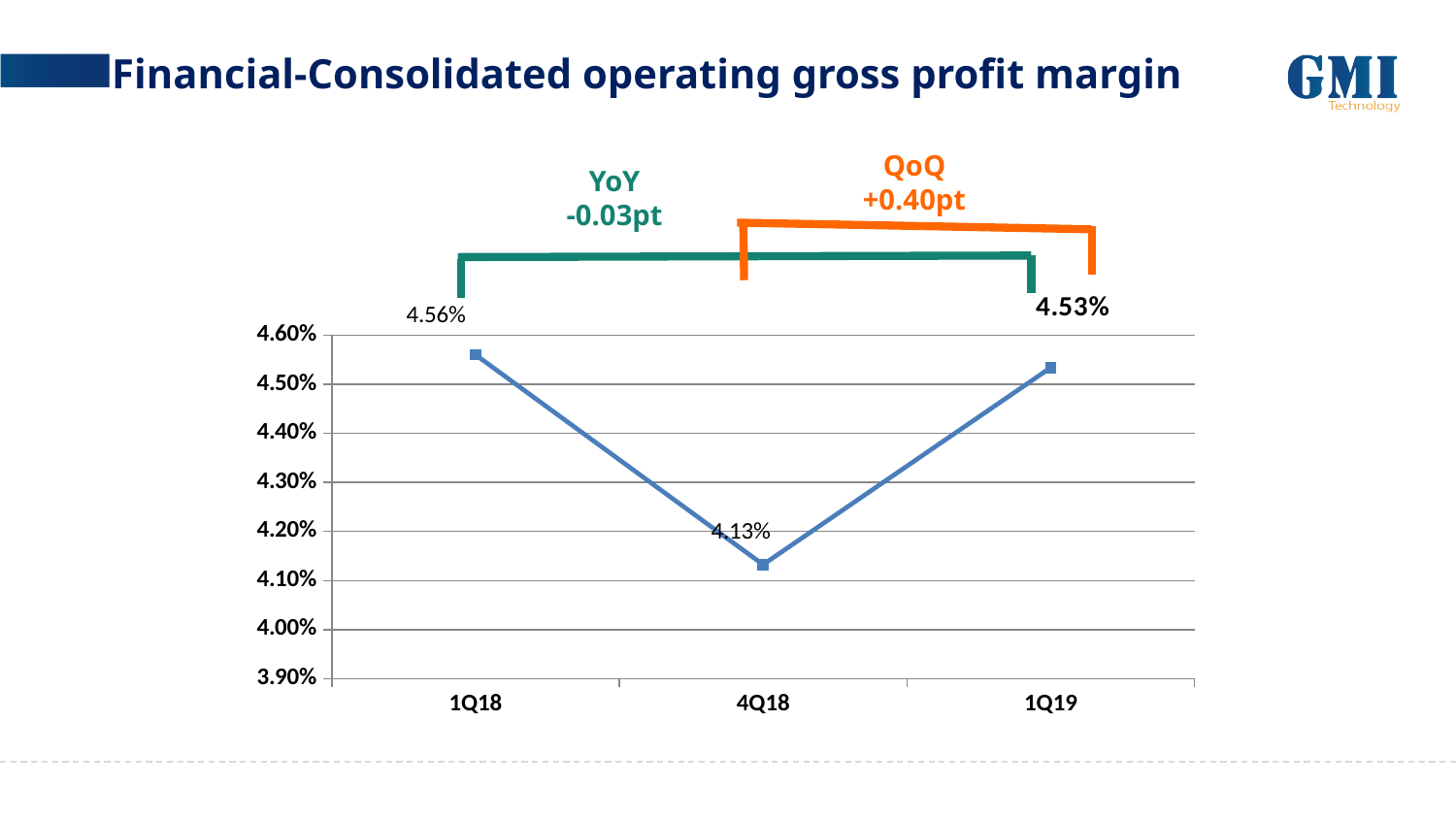
What is the difference in operating gross profit margin between 1Q19 and 4Q18? 0.40pt Is the value for 4Q18 greater or less than 4.20%? less What is the consolidated operating gross profit margin for 4Q18? 4.13% What is the consolidated operating gross profit margin for 1Q18? 4.56% How many quarters are plotted on the chart? 3 Is the operating gross profit margin higher in 1Q19 or in 4Q18? 1Q19 Which quarter has the highest operating gross profit margin? 1Q18 Which quarter has the lowest operating gross profit margin? 4Q18 What kind of chart is shown on the slide? line chart What is the difference in operating gross profit margin between 1Q18 and 1Q19? 0.03pt What is the QoQ change in operating gross profit margin shown on the slide? +0.40pt What is the consolidated operating gross profit margin for 1Q19? 4.53%